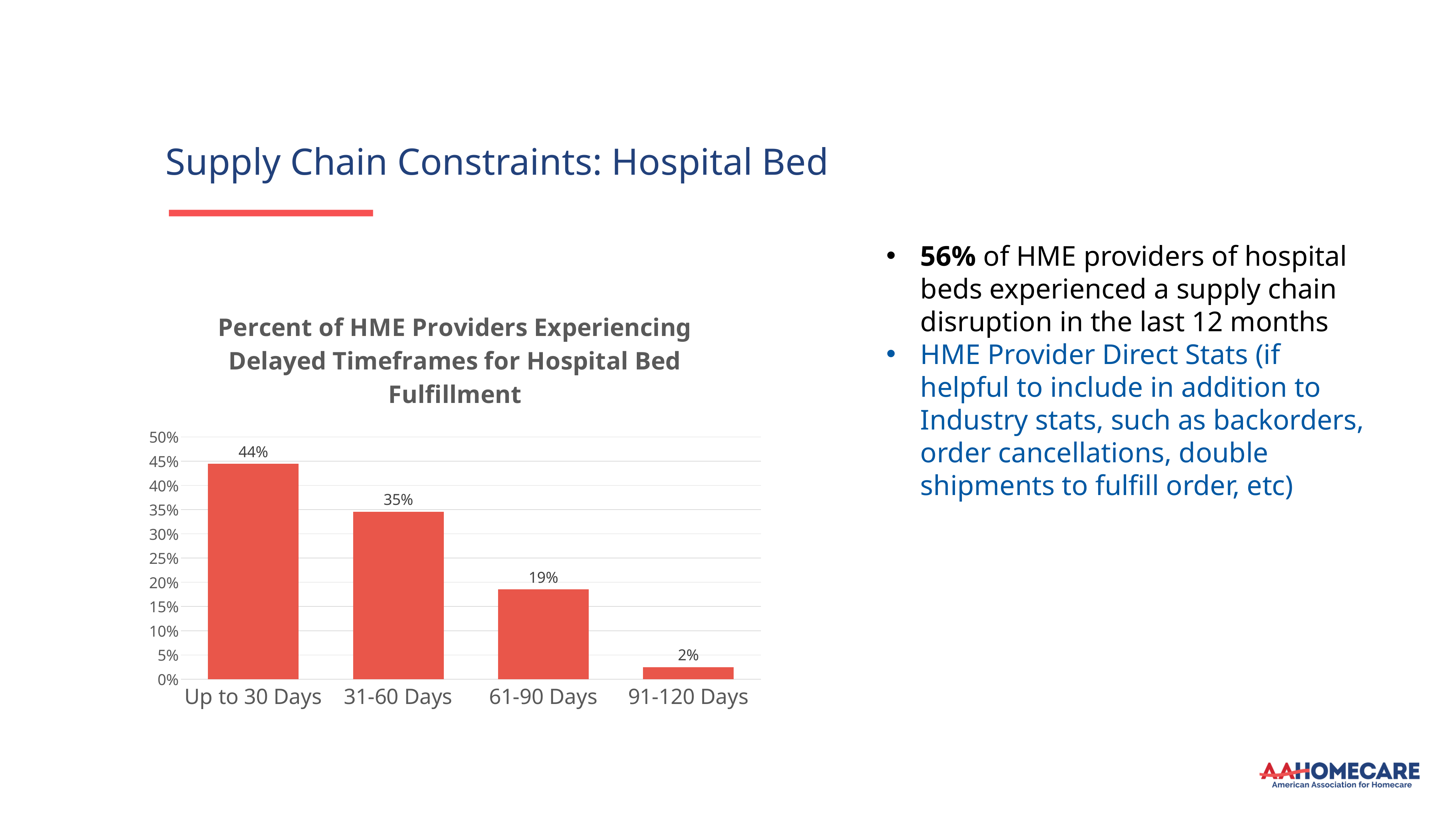
Do the values rise or fall from left to right along the x axis? Fall What is the difference between the values for Up to 30 Days and 31-60 Days? 9% Which category has the lowest value? 91-120 Days What is the difference between the values for 61-90 Days and 91-120 Days? 17% What kind of chart is shown on the slide? Bar chart What is the value for 31-60 Days? 35% What is the value for 61-90 Days? 19% Which is larger, the value for 31-60 Days or the value for 61-90 Days? 31-60 Days What is the value for Up to 30 Days? 44% Which category has the highest value? Up to 30 Days What is the value for 91-120 Days? 2% How many categories are shown on the x axis? 4